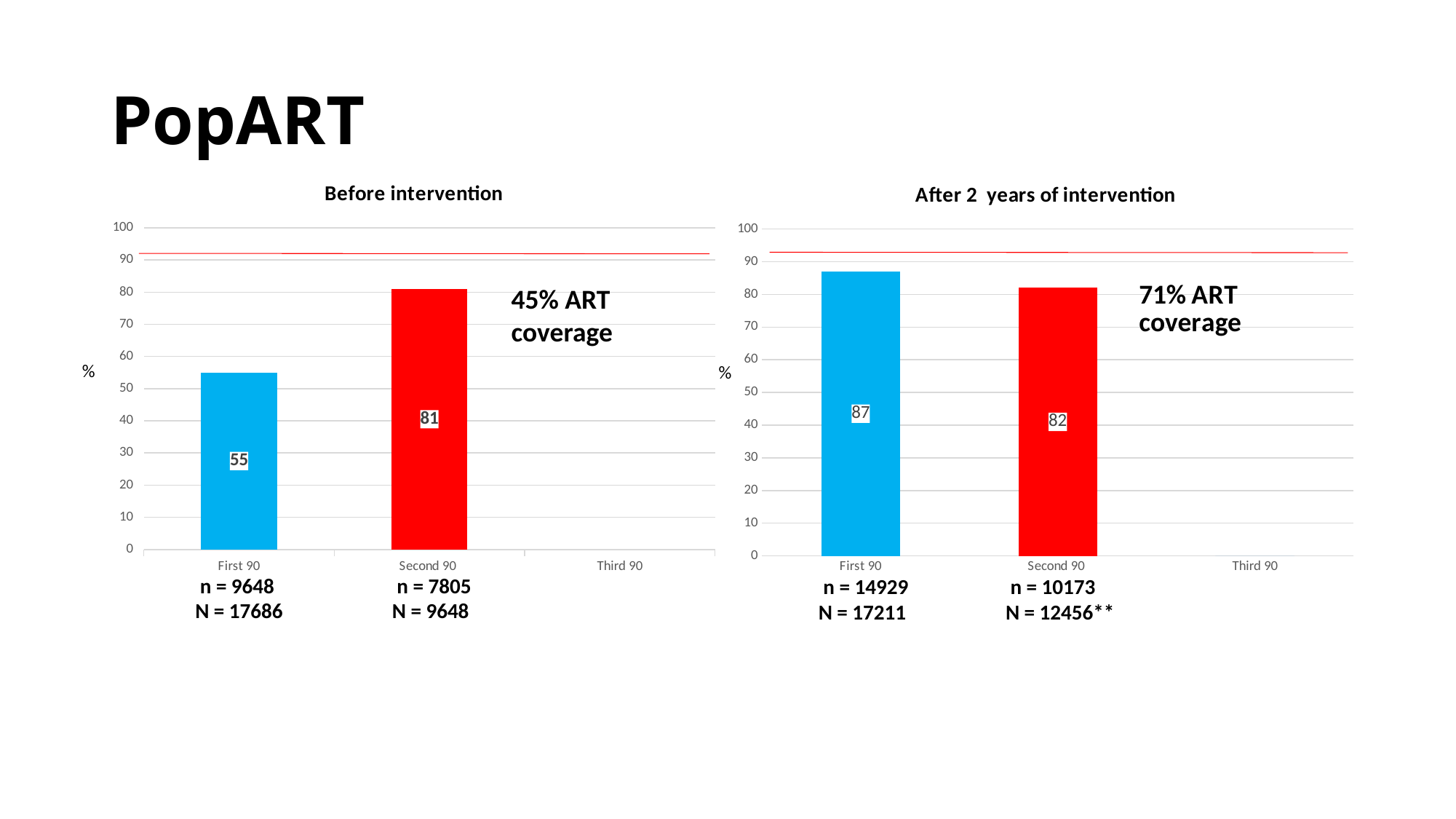
What ART coverage percentage is annotated on the 'After 2 years of intervention' chart? 71% In the 'After 2 years of intervention' chart, what is the value for First 90? 87 In the 'After 2 years of intervention' chart, what is the difference between the First 90 and Second 90 values? 5 In the 'After 2 years of intervention' chart, what is the value for Second 90? 82 In the 'Before intervention' chart, which category has the highest value? Second 90 In the 'Before intervention' chart, what is the difference between the Second 90 and First 90 values? 26 In the 'Before intervention' chart, is the value for First 90 greater or less than 60? less Is the First 90 value in the 'Before intervention' chart larger or smaller than the First 90 value in the 'After 2 years of intervention' chart? smaller In the 'Before intervention' chart, what is the value for First 90? 55 What kind of chart is the 'After 2 years of intervention' chart? bar chart In the 'Before intervention' chart, what is the value for Second 90? 81 In the 'After 2 years of intervention' chart, which category has the highest value? First 90